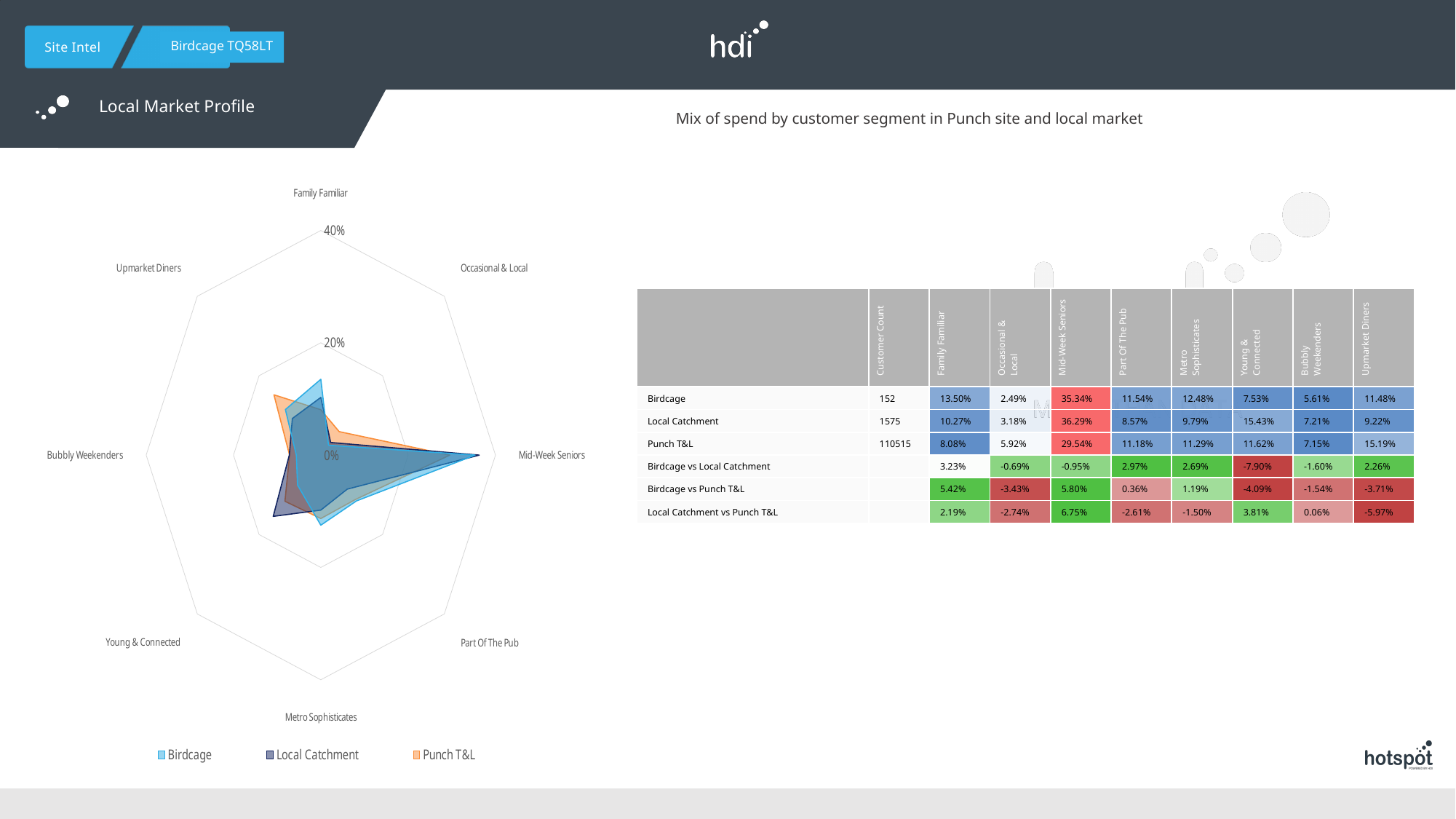
What kind of chart is shown on the left of the slide? Radar chart On the radar chart, is the Birdcage value for Family Familiar greater or less than 20%? less For Young & Connected, which is larger: Birdcage or Local Catchment? Local Catchment How many series does the radar chart's legend list? 3 By how much does the Local Catchment value for Mid-Week Seniors exceed the Birdcage value? 0.95% On the radar chart, is the Birdcage value for Mid-Week Seniors greater or less than 20%? greater How many customer segments (categories) are plotted on the radar chart? 8 What are the three series named in the radar chart's legend? Birdcage, Local Catchment, Punch T&L What is the Birdcage value for Mid-Week Seniors? 35.34% What is the Punch T&L value for Upmarket Diners? 15.19% Which customer segment has the highest value for Birdcage on the radar chart? Mid-Week Seniors What is the highest value shown on the radar chart's axis scale? 40%